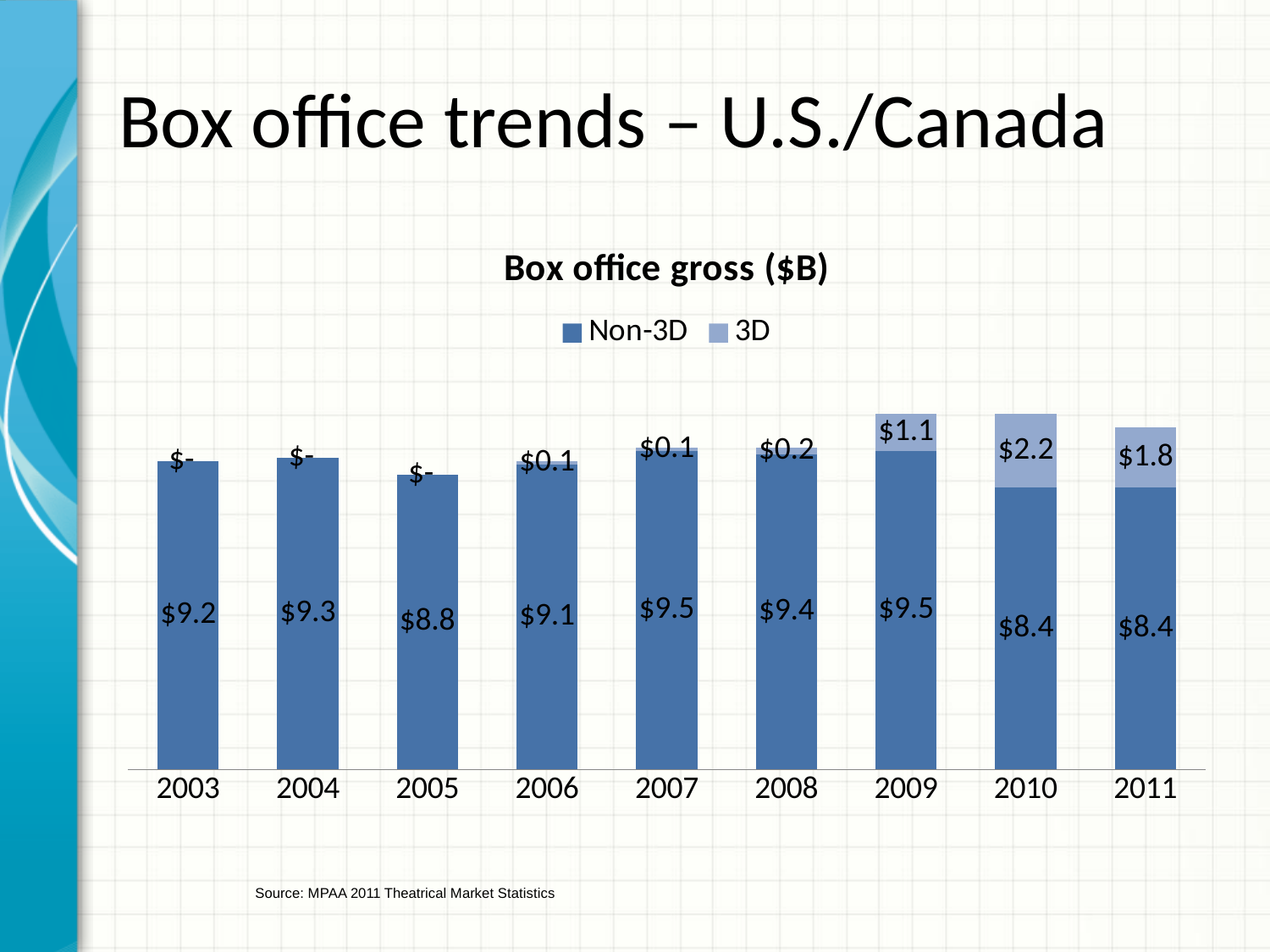
How many series does the chart's legend list? 2 What is the Non-3D box office gross for 2005? $8.8 What is the total box office gross (Non-3D plus 3D) for 2011? $10.2 What is the 3D box office gross for 2009? $1.1 How many years are shown on the x axis of the chart? 9 What is the 3D box office gross for 2010? $2.2 Which year has the highest 3D box office gross? 2010 What kind of chart is shown on the slide? Stacked bar chart What is the total box office gross (Non-3D plus 3D) for 2010? $10.6 Which is larger, the Non-3D box office gross in 2007 or in 2005? 2007 Which year between 2003 and 2009 has the lowest Non-3D box office gross? 2005 What is the difference between the 3D box office gross in 2010 and in 2011? $0.4